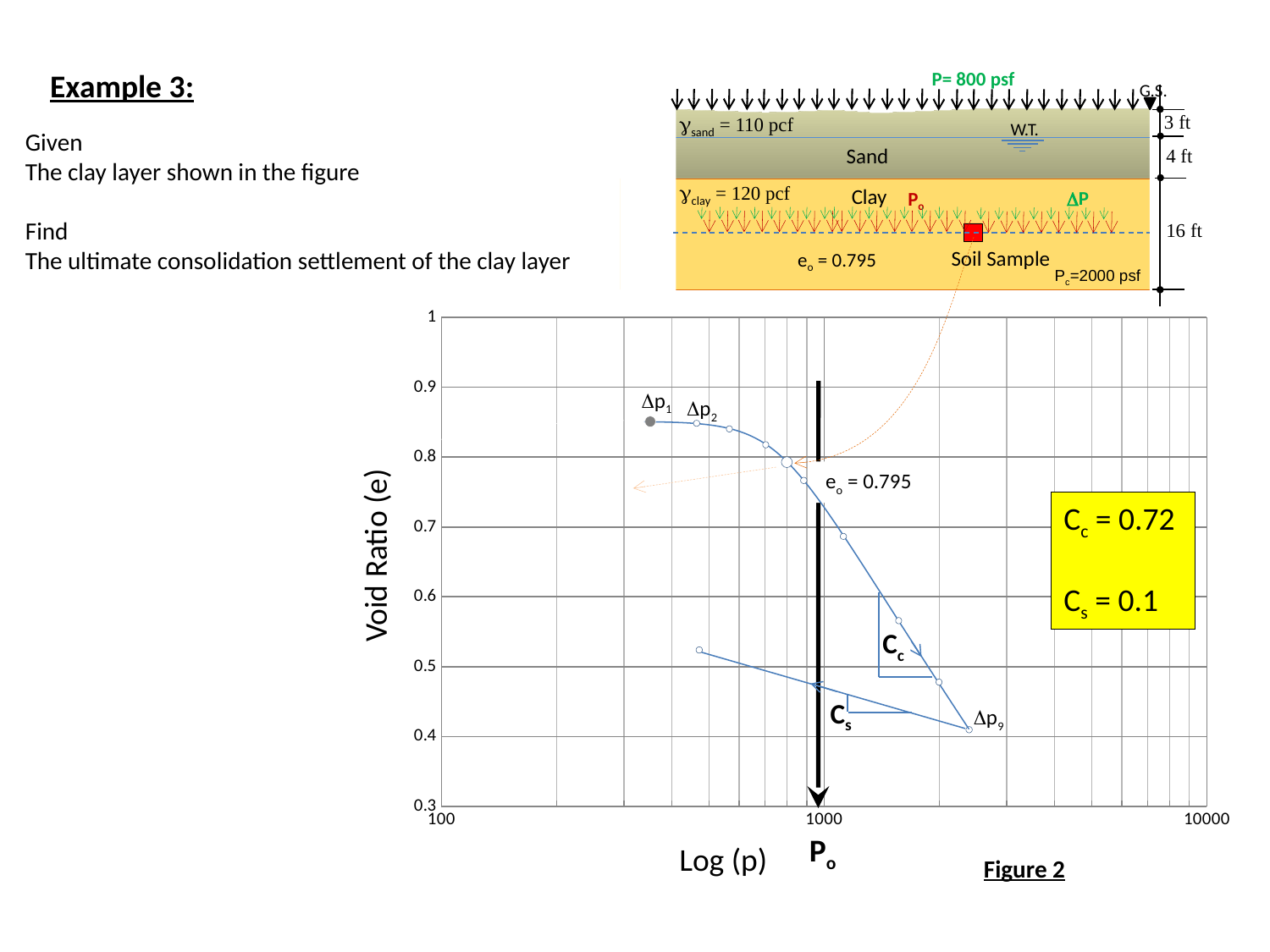
What is the value of e_o marked on the chart? 0.795 What is the lowest value shown on the vertical axis of the chart? 0.3 Does the void ratio rise or fall as p increases along the x axis? fall What value of Cc is given in the box on the chart? 0.72 What kind of chart is Figure 2? line chart What is the title of the vertical axis of the chart? Void Ratio (e) What value of Cs is given in the box on the chart? 0.1 Which labelled point has the higher void ratio, Δp2 or Δp9? Δp2 Which of the labelled points (Δp1, Δp2, Δp9) has the lowest void ratio? Δp9 Is the void ratio at the point labelled Δp9 greater or less than 0.5? less What is the title of the horizontal axis of the chart? Log (p) Is the void ratio at the point labelled Δp1 greater or less than 0.8? greater